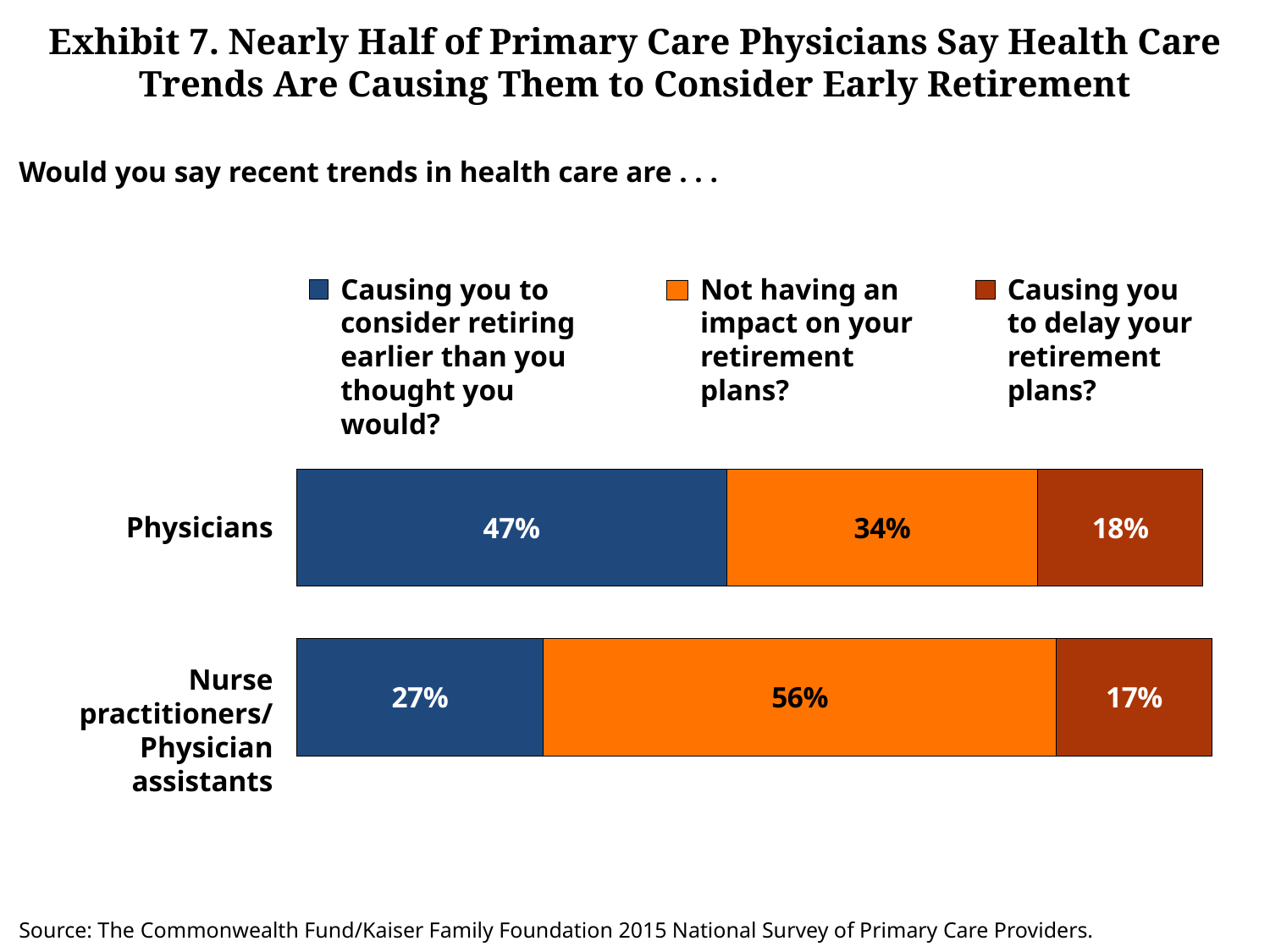
What is the difference in percentage points between physicians and nurse practitioners/physician assistants who say trends are causing them to consider retiring earlier? 20 percentage points What percentage of nurse practitioners/physician assistants say recent health care trends are causing them to consider retiring earlier than they thought they would? 27% Which group has the higher share saying health care trends are causing them to consider retiring earlier: physicians or nurse practitioners/physician assistants? Physicians Which response category has the largest share among nurse practitioners/physician assistants? Not having an impact on your retirement plans? What is the difference in percentage points between the 'not having an impact' shares for nurse practitioners/physician assistants and physicians? 22 percentage points How many provider groups are shown in the chart? 2 How many series does the legend list? 3 What percentage of physicians say recent health care trends are causing them to consider retiring earlier than they thought they would? 47% What percentage of nurse practitioners/physician assistants say recent health care trends are not having an impact on their retirement plans? 56% What percentage of physicians say recent health care trends are causing them to delay their retirement plans? 18% Which response category has the smallest share among physicians? Causing you to delay your retirement plans? What type of chart is shown on the slide? Stacked bar chart